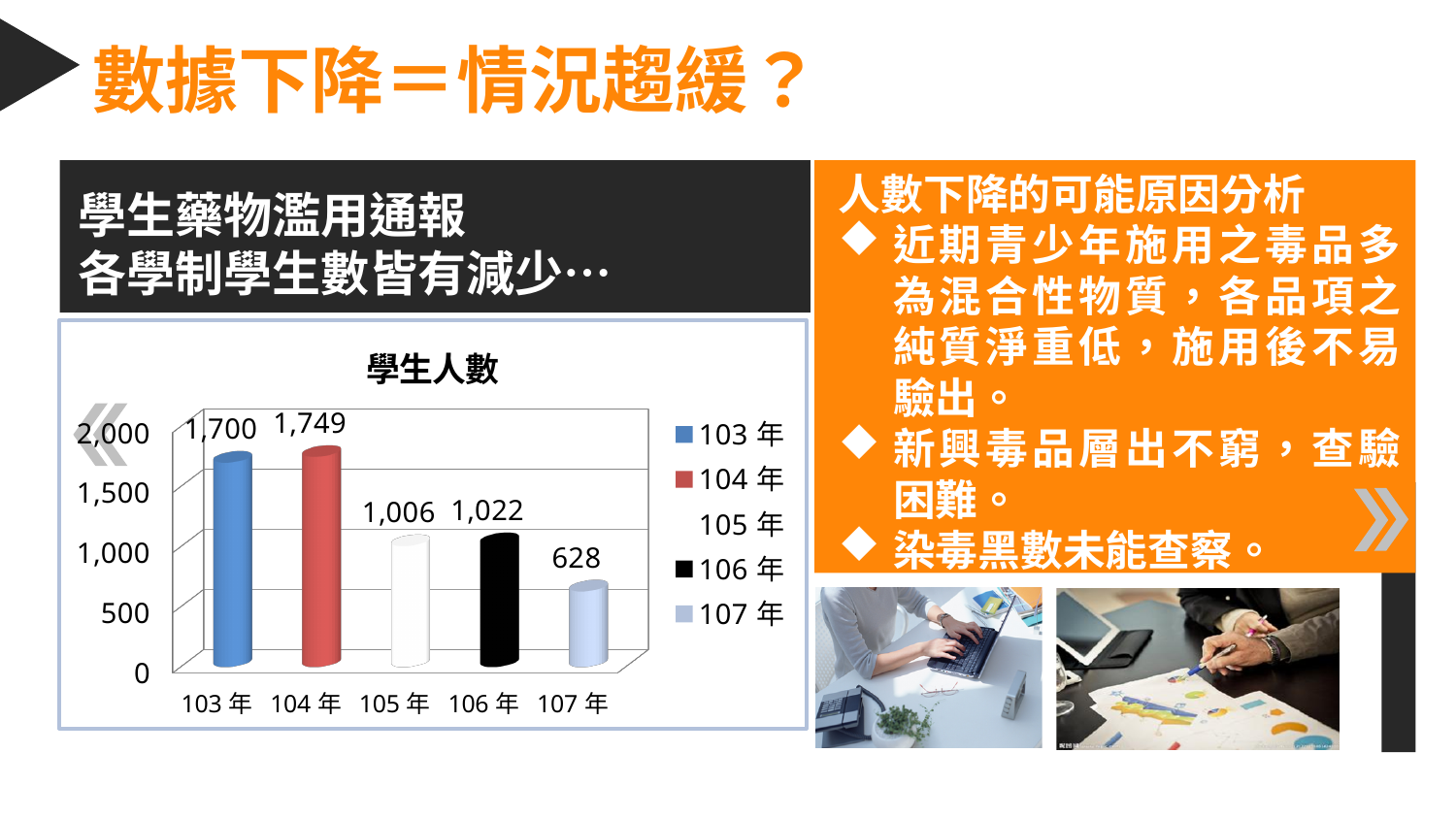
Is the value for 107 年 in the 學生人數 chart greater or less than 1,000? less What is the title of the chart on the slide? 學生人數 What is the value for 107 年 in the 學生人數 chart? 628 Which year has the lowest value in the 學生人數 chart? 107 年 What is the value for 105 年 in the 學生人數 chart? 1,006 What is the difference between the values for 106 年 and 107 年 in the 學生人數 chart? 394 What is the difference between the values for 104 年 and 103 年 in the 學生人數 chart? 49 Which is larger in the 學生人數 chart, the value for 105 年 or 106 年? 106 年 What is the value for 103 年 in the 學生人數 chart? 1,700 Which year has the highest value in the 學生人數 chart? 104 年 What kind of chart is the 學生人數 chart? bar chart How many years are shown on the x axis of the 學生人數 chart? 5